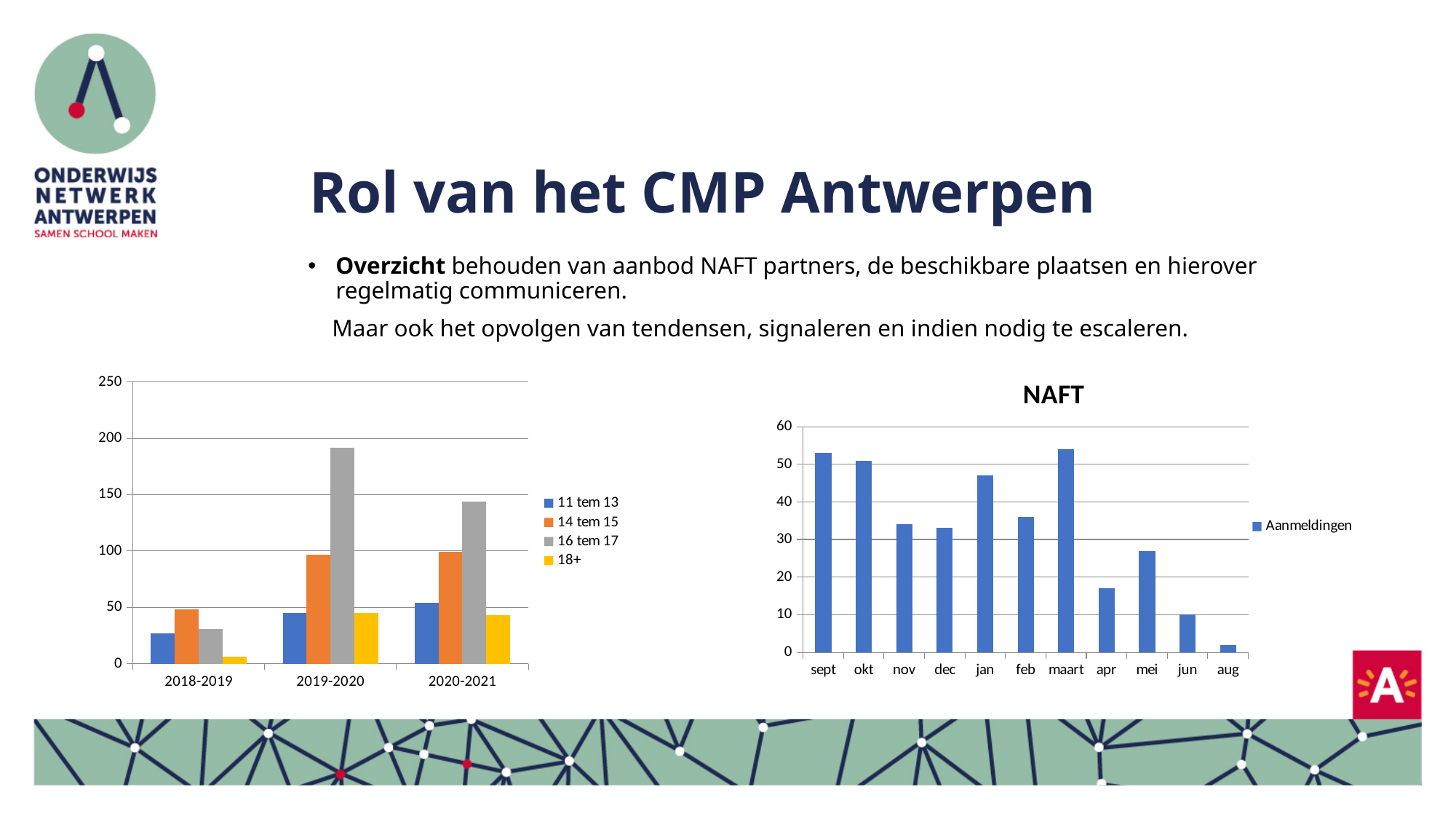
How many series does the legend of the left chart list? 4 What series name does the legend of the NAFT chart show? Aanmeldingen In the NAFT chart, is the value for jan greater or less than 40? greater In the NAFT chart, is the value for apr greater or less than 20? less What kind of chart is the chart on the left of the slide? bar chart In the NAFT chart, how many months are shown on the x axis? 11 In the left chart, is the 16 tem 17 value larger in 2019-2020 or in 2020-2021? 2019-2020 In the left chart, is the value for 18+ in 2018-2019 greater or less than 50? less How many school-year categories are shown on the x axis of the left chart? 3 In the left chart, which age group has the highest value for 2019-2020? 16 tem 17 In the NAFT chart, which month has the lowest number of Aanmeldingen? aug